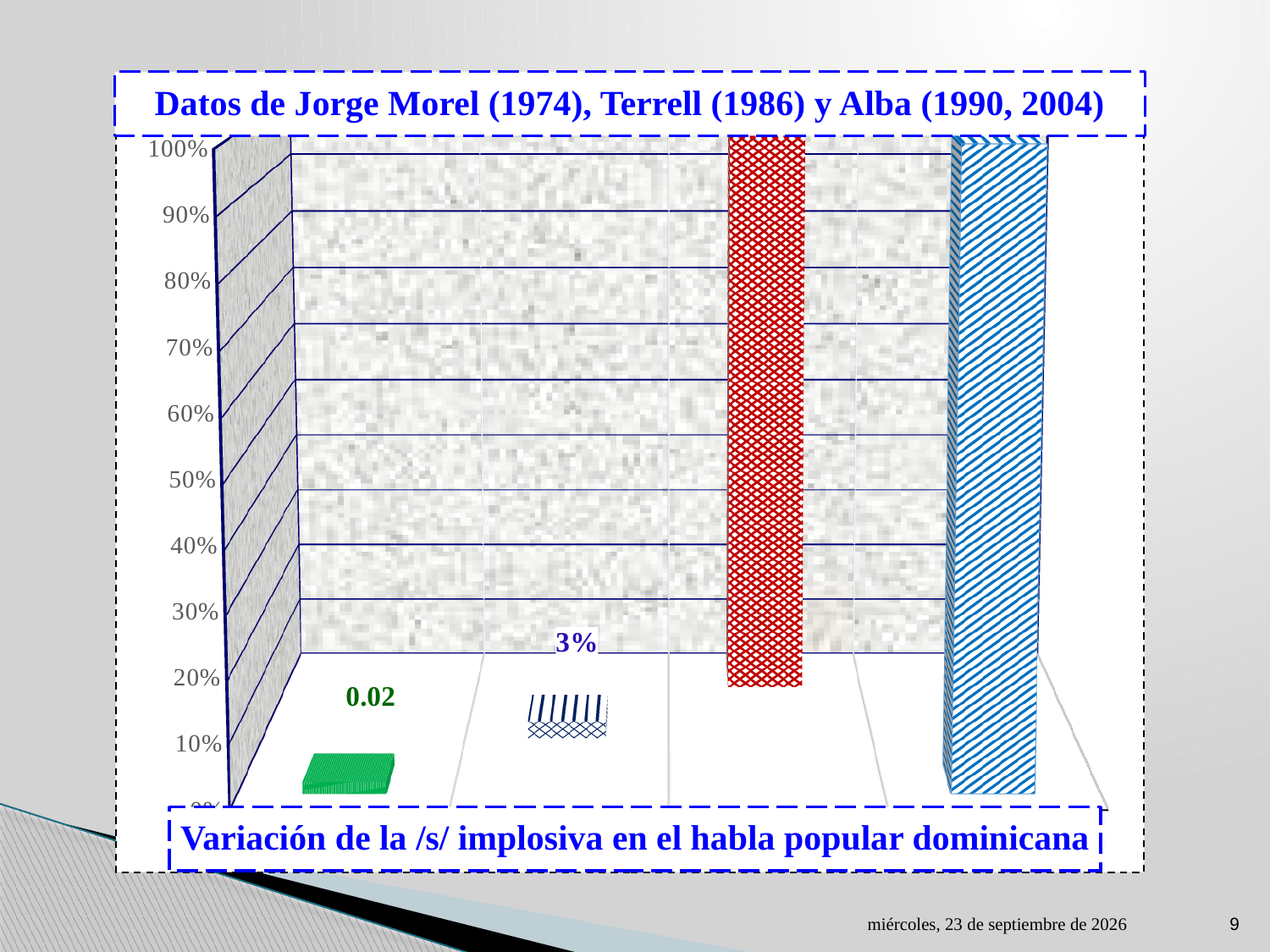
What is the highest value shown on the vertical axis? 100% What value is printed above the second bar from the left (the small hatched bar)? 3% Which is larger, the red cross-hatched bar or the green bar on the far left? the red cross-hatched bar Is the value of the red cross-hatched bar greater or less than 50%? greater What kind of chart is shown on the slide? bar chart What text appears in the box above the chart? Datos de Jorge Morel (1974), Terrell (1986) y Alba (1990, 2004) Which bar is the lowest in the chart? the green bar on the far left Is the value of the blue striped bar on the far right greater or less than 90%? greater What is the title shown beneath the chart? Variación de la /s/ implosiva en el habla popular dominicana What value is printed above the green bar on the far left of the chart? 0.02 How many bars are plotted in the chart? 4